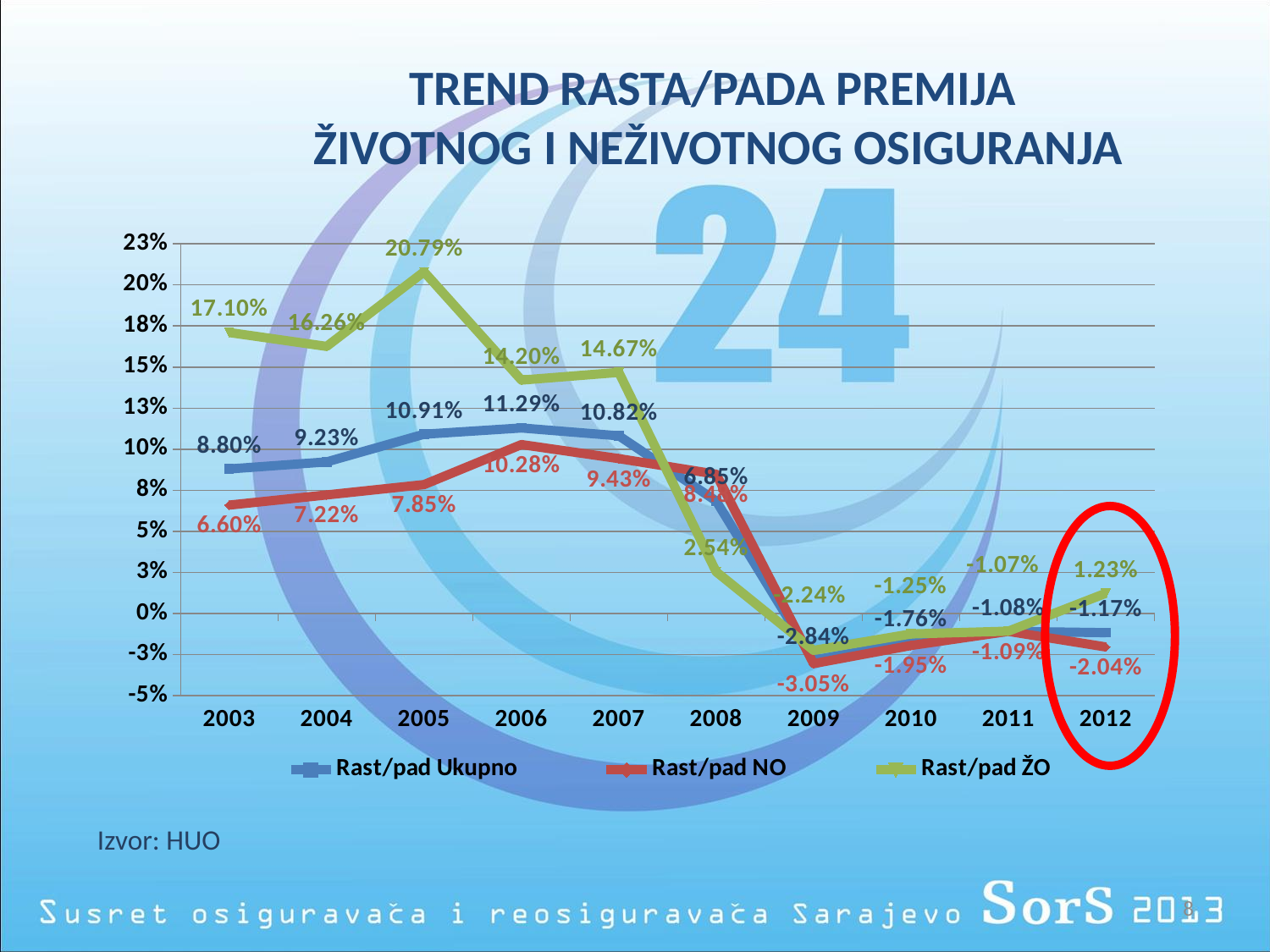
What is the value of Rast/pad ŽO in 2012? 1.23% In which year does Rast/pad ŽO reach its highest value? 2005 In which year does Rast/pad Ukupno reach its lowest value? 2009 What is the value of Rast/pad Ukupno in 2006? 11.29% What kind of chart is shown on the slide? Line chart Which is larger in 2012: Rast/pad NO or Rast/pad ŽO? Rast/pad ŽO How many series does the legend list? 3 What is the difference between Rast/pad ŽO and Rast/pad Ukupno in 2003? 8.30% Does Rast/pad Ukupno rise or fall from 2007 to 2009? Fall How many years are shown on the x axis? 10 What is the value of Rast/pad ŽO in 2005? 20.79% What is the value of Rast/pad NO in 2009? -3.05%